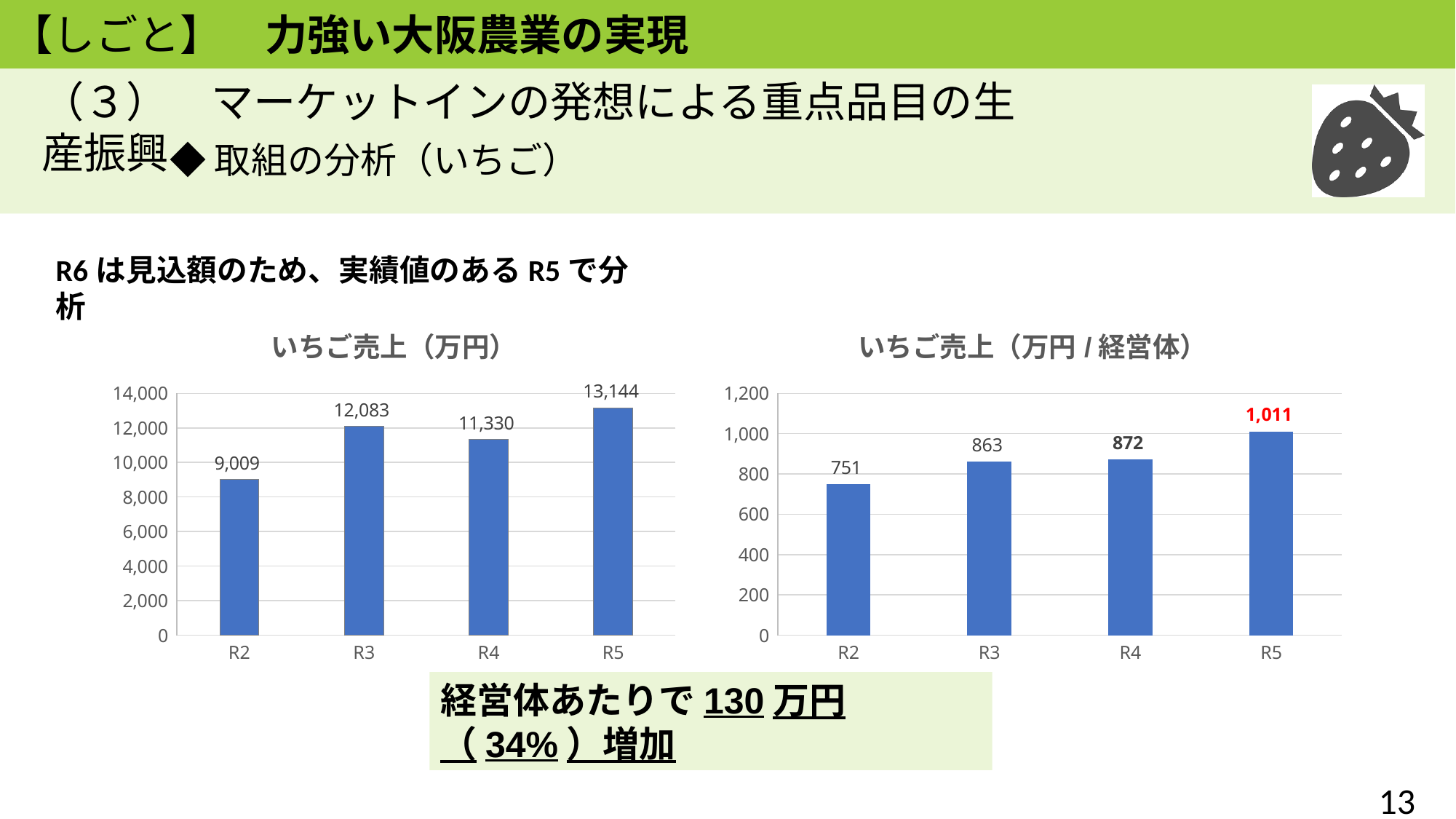
In the left chart titled いちご売上（万円）, what is the value for R2? 9,009 In the right chart titled いちご売上（万円/経営体）, what is the value for R2? 751 In the left chart titled いちご売上（万円）, what is the value for R4? 11,330 In the right chart titled いちご売上（万円/経営体）, what is the value for R5? 1,011 In the left chart titled いちご売上（万円）, what is the difference between the R5 and R2 values? 4,135 In the left chart titled いちご売上（万円）, which is larger, the value for R3 or the value for R4? R3 How many categories are shown on the x axis of the right chart titled いちご売上（万円/経営体）? 4 In the left chart titled いちご売上（万円）, which year has the highest value? R5 In the left chart titled いちご売上（万円）, which year has the lowest value? R2 In the right chart titled いちご売上（万円/経営体）, do the values rise or fall from R2 to R5? rise What kind of chart is the left chart titled いちご売上（万円）? bar chart In the right chart titled いちご売上（万円/経営体）, what is the difference between the R5 and R4 values? 139